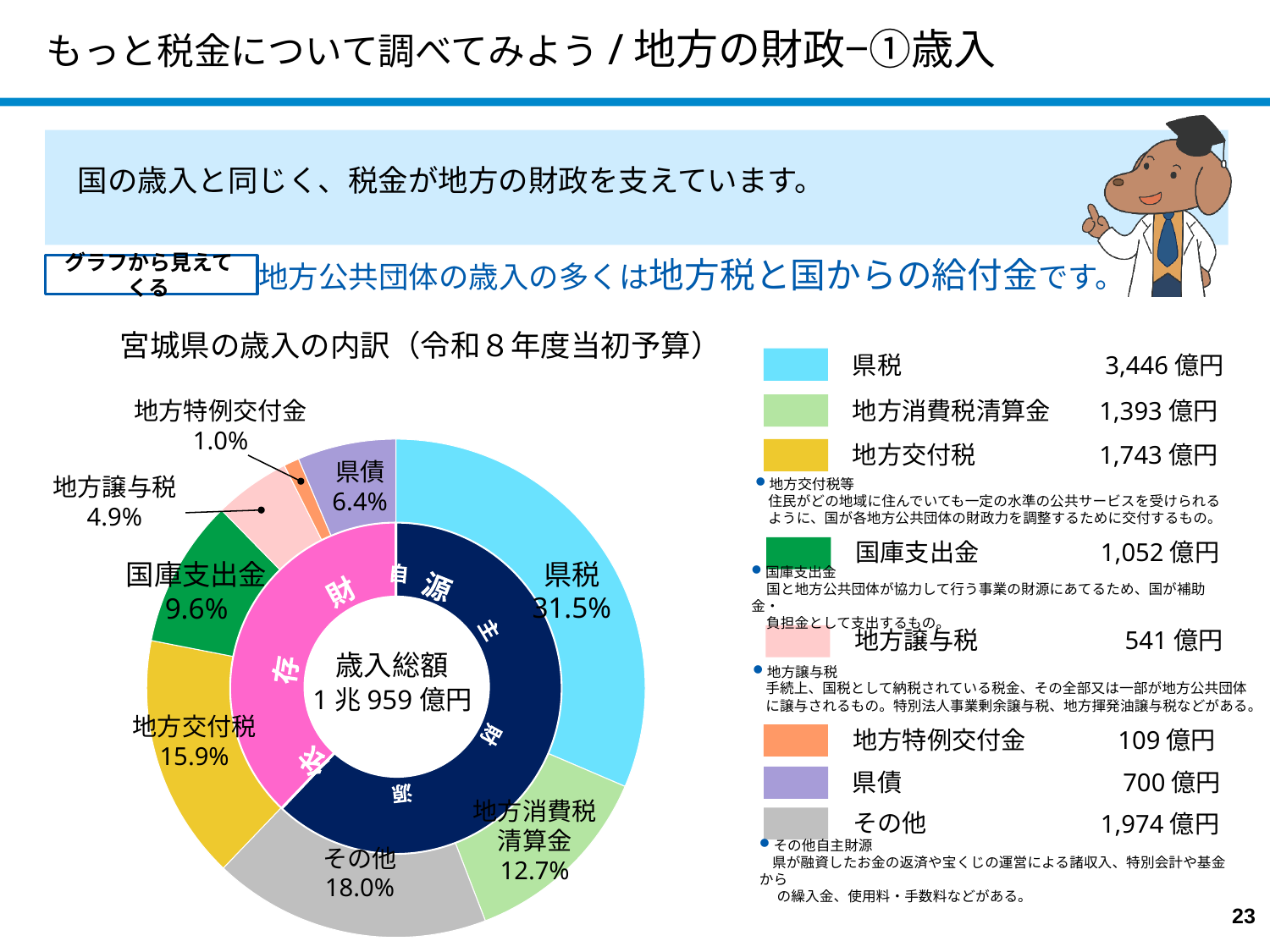
グラフの中央に示されている歳入総額はいくらですか。 1兆959億円 このグラフはどの種類のグラフですか。 円グラフ（ドーナツグラフ） 歳入の内訳で最も割合が小さい項目はどれですか。 地方特例交付金 県税の割合は何％ですか。 31.5% 国庫支出金と県債では、どちらの割合が大きいですか。 国庫支出金 その他と地方交付税の割合の差は何ポイントですか。 2.1ポイント 地方特例交付金の割合は何％ですか。 1.0% 凡例に示されている地方消費税清算金の金額はいくらですか。 1,393億円 地方交付税の割合は何％ですか。 15.9% 歳入の内訳で最も割合が大きい項目はどれですか。 県税 凡例に示されている県債の金額はいくらですか。 700億円 グラフのタイトルは何ですか。 宮城県の歳入の内訳（令和８年度当初予算）